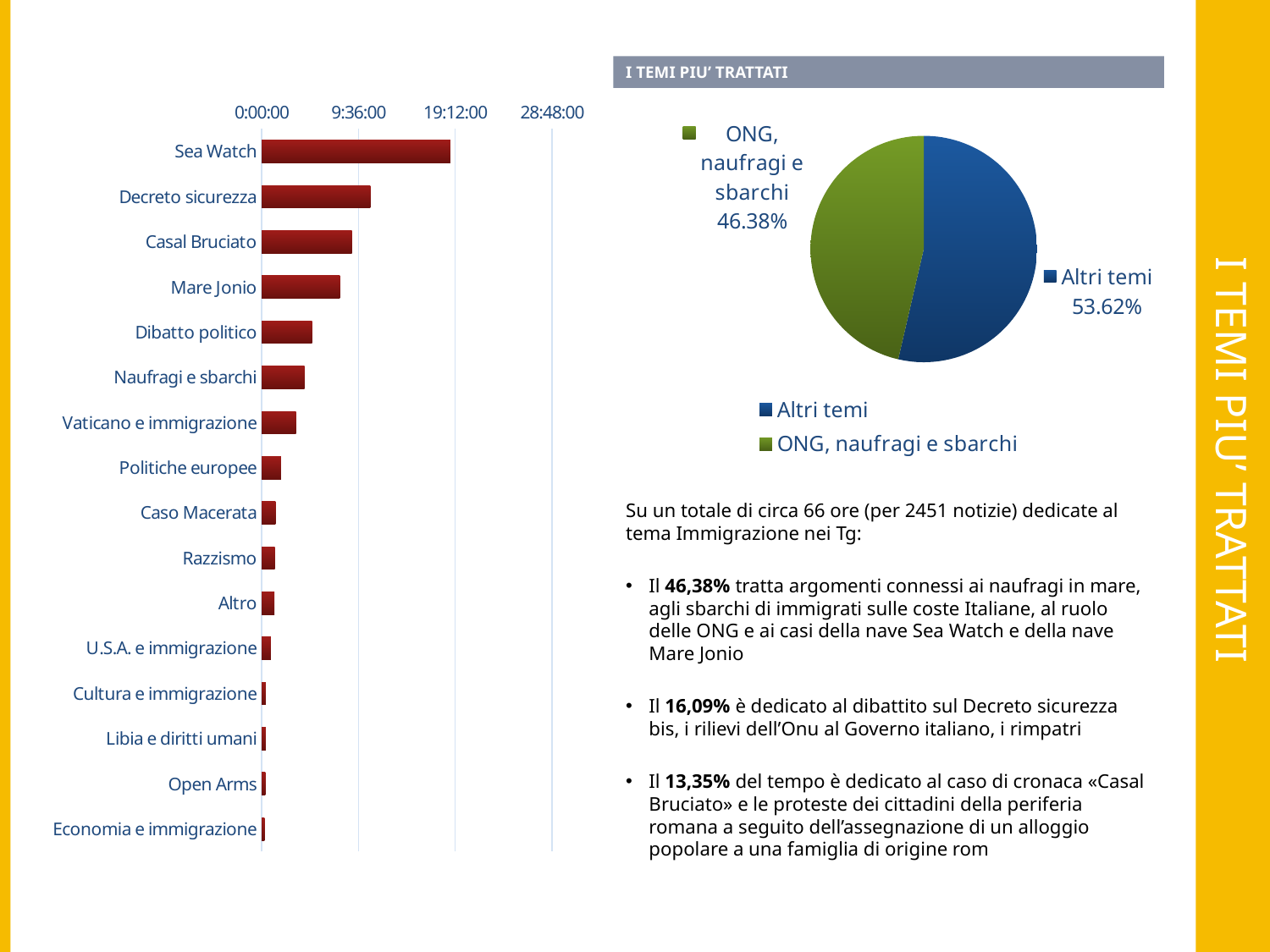
In the bar chart on the left side of the slide, is the value for 'Decreto sicurezza' greater or less than 9:36:00? greater What kind of chart is the chart on the left side of the slide? Bar chart In the pie chart titled 'I TEMI PIU' TRATTATI', what share is shown for 'ONG, naufragi e sbarchi'? 46.38% In the pie chart titled 'I TEMI PIU' TRATTATI', how many entries does the legend list? 2 In the bar chart on the left side of the slide, which is larger: the value for 'Mare Jonio' or the value for 'Dibatto politico'? Mare Jonio In the pie chart titled 'I TEMI PIU' TRATTATI', what is the difference in percentage points between 'Altri temi' and 'ONG, naufragi e sbarchi'? 7.24 In the bar chart on the left side of the slide, which category has the shortest bar? Economia e immigrazione In the bar chart on the left side of the slide, is the value for 'Mare Jonio' greater or less than 9:36:00? less In the pie chart titled 'I TEMI PIU' TRATTATI', what share is shown for 'Altri temi'? 53.62% In the bar chart on the left side of the slide, which category has the longest bar? Sea Watch In the pie chart titled 'I TEMI PIU' TRATTATI', which slice is the largest? Altri temi In the bar chart on the left side of the slide, how many categories are shown? 16